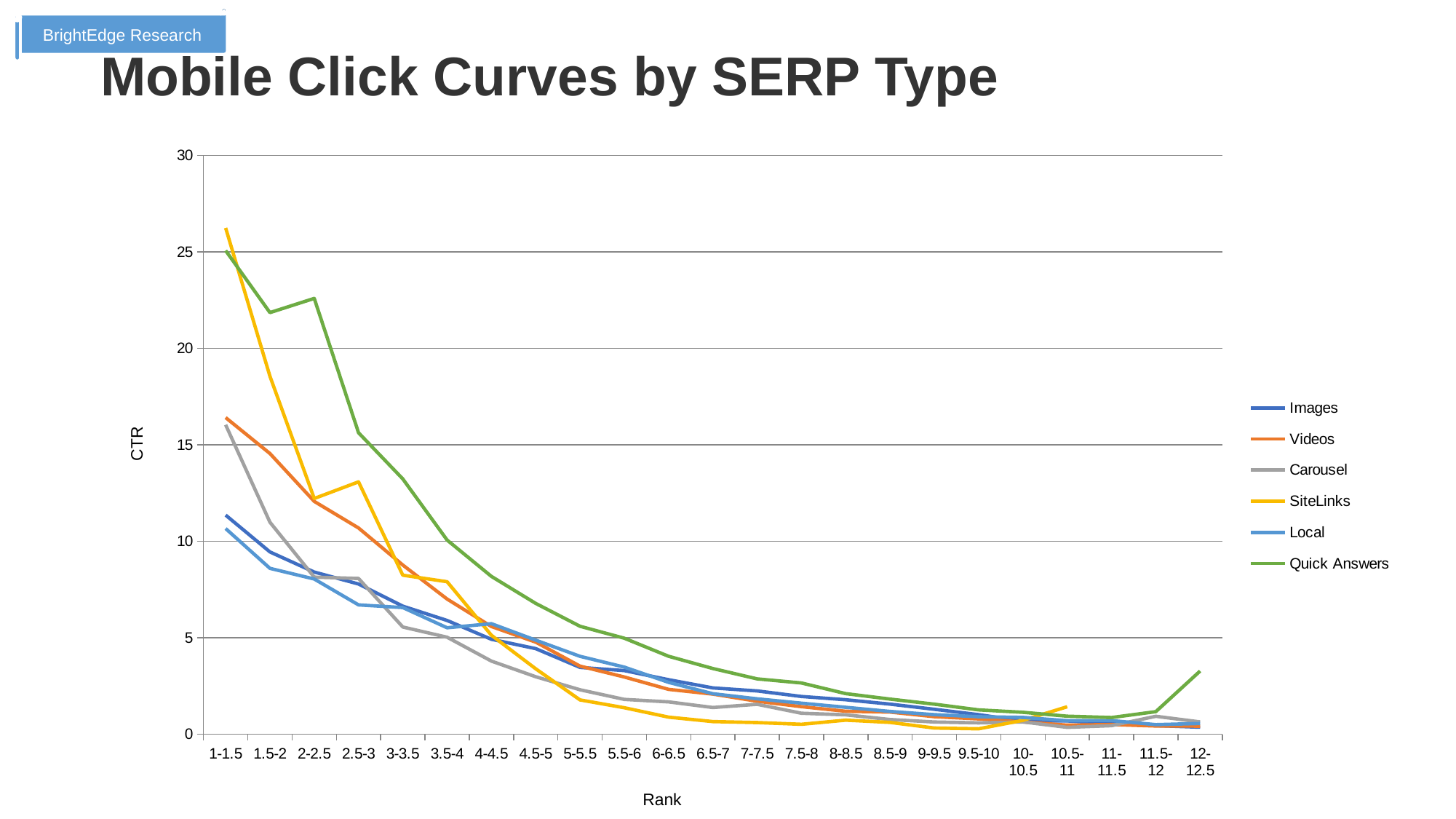
Is the CTR for SiteLinks at rank 1-1.5 greater or less than 25? greater What kind of chart is shown on the slide? Line chart What is the title of the chart? Mobile Click Curves by SERP Type Which series has the highest CTR at rank 2-2.5? Quick Answers At rank 1-1.5, which has the higher CTR: Videos or Images? Videos Does the CTR for Quick Answers generally rise or fall from rank 1-1.5 to rank 9.5-10? Fall Is the CTR for Videos at rank 1-1.5 greater or less than 15? greater Is the CTR for Images at rank 1-1.5 greater or less than 15? less How many rank categories are shown along the x axis? 23 How many series does the legend list? 6 Which series has the highest CTR at rank 12-12.5? Quick Answers